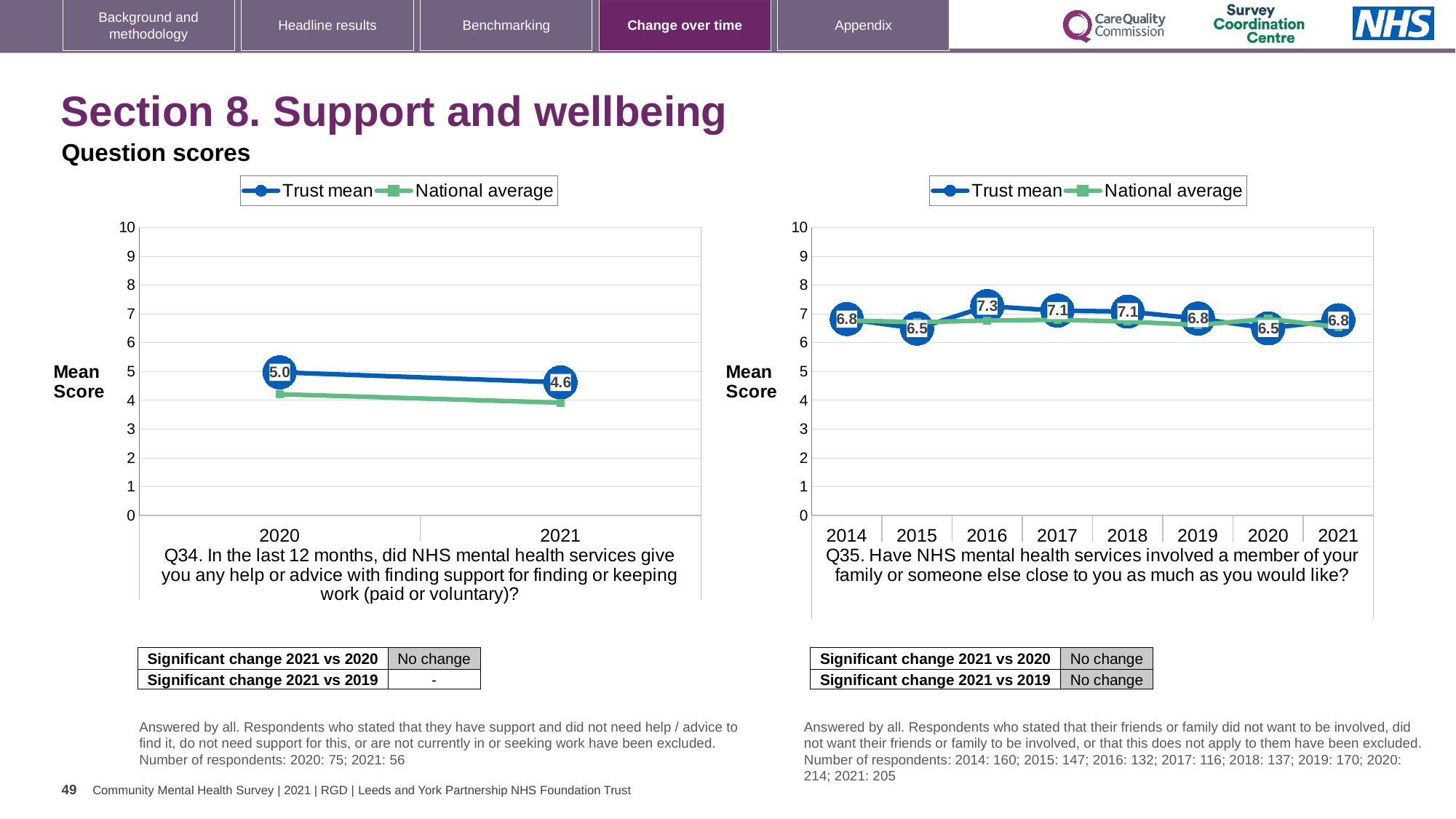
On the left chart (Q34), is the National average for 2021 greater or less than 5? less On the right chart (Q35), which year has the highest Trust mean? 2016 On the right chart (Q35), what is the Trust mean for 2021? 6.8 On the left chart (Q34), what is the Trust mean for 2020? 5.0 What type of chart is the left chart (Q34)? line chart On the left chart (Q34), what is the Trust mean for 2021? 4.6 On the right chart (Q35), what is the difference between the Trust mean in 2016 and in 2020? 0.8 On the right chart (Q35), how many years are shown on the x axis? 8 On the left chart (Q34), by how much did the Trust mean fall from 2020 to 2021? 0.4 On the right chart (Q35), how many series does the legend list? 2 On the left chart (Q34), does the Trust mean rise or fall from 2020 to 2021? fall On the right chart (Q35), what is the Trust mean for 2016? 7.3